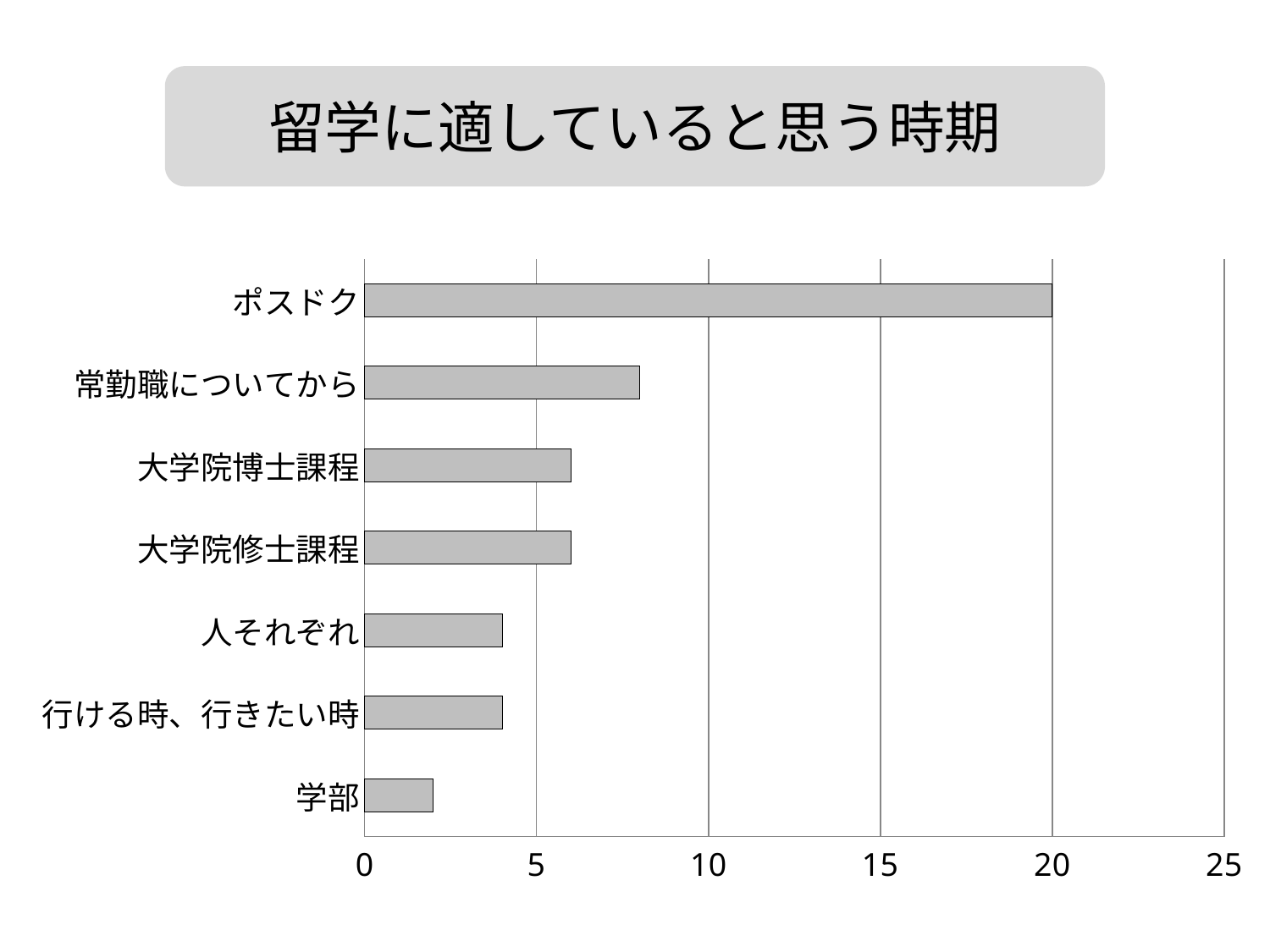
Is the value for 常勤職についてから greater or less than 5? greater Which is larger, the value for 人それぞれ or the value for 学部? 人それぞれ Which is larger, the value for 常勤職についてから or the value for 大学院博士課程? 常勤職についてから Which category has the highest value? ポスドク What kind of chart is shown on the slide? bar chart What is the value for ポスドク? 20 Which category has the lowest value? 学部 Is the value for 大学院博士課程 greater or less than 5? greater Is the value for 学部 greater or less than 5? less How many categories are plotted in the chart? 7 What is the title of the chart? 留学に適していると思う時期